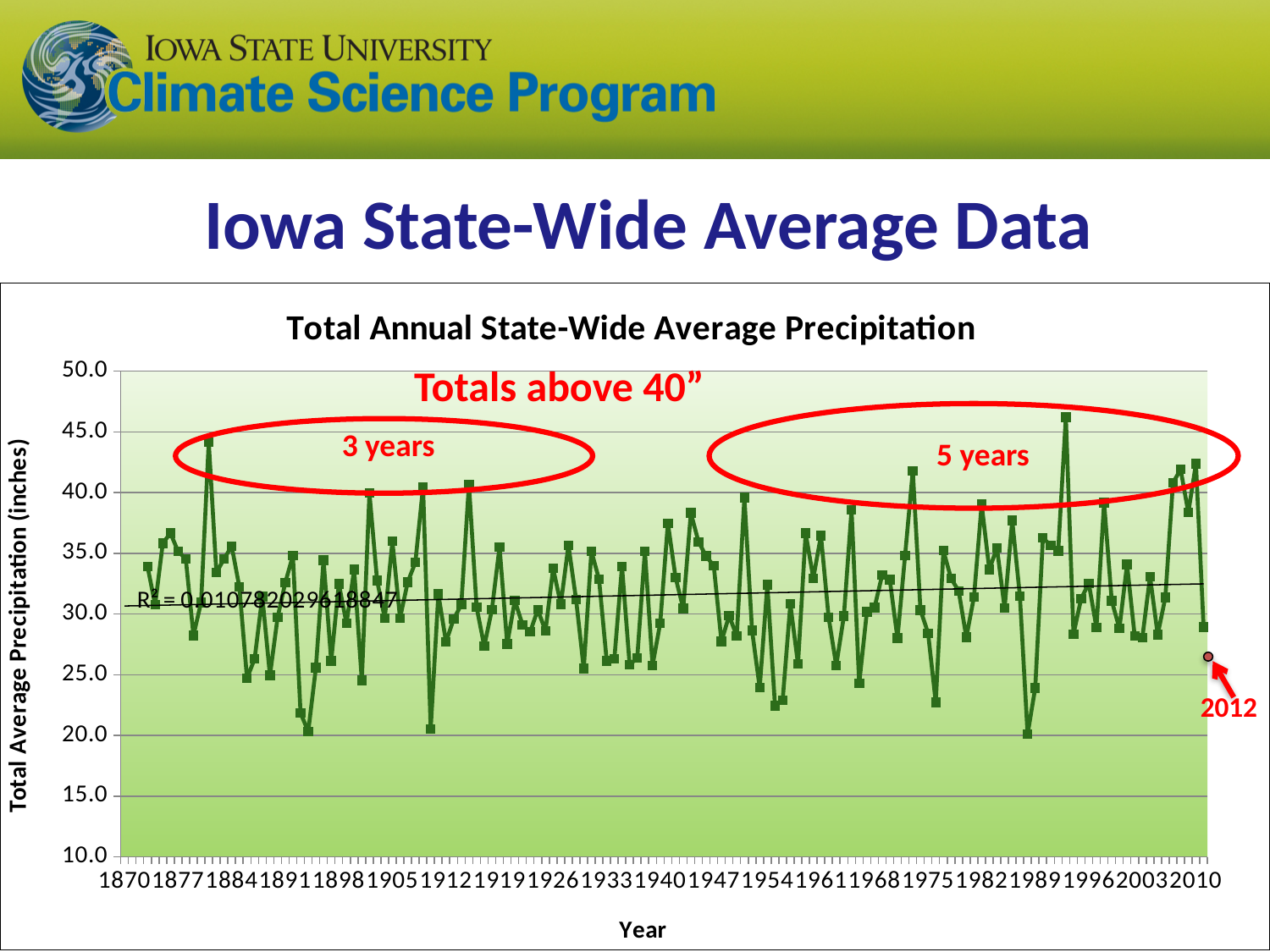
According to the annotation, how many years in the first circled period had totals above 40 inches? 3 years What kind of chart is shown on the slide? Line chart Is the value for 2012 greater or less than 30? less What is the first year shown on the x axis? 1870 According to the annotation, how many years in the second circled period had totals above 40 inches? 5 years What is the label on the vertical axis of the chart? Total Average Precipitation (inches) Is the value for 2012 greater or less than 20? greater What is the highest value shown on the y axis? 50.0 Does the fitted trend line rise or fall from left to right across the chart? rises Is the highest value on the chart greater or less than 40? greater What is the title of the chart? Total Annual State-Wide Average Precipitation